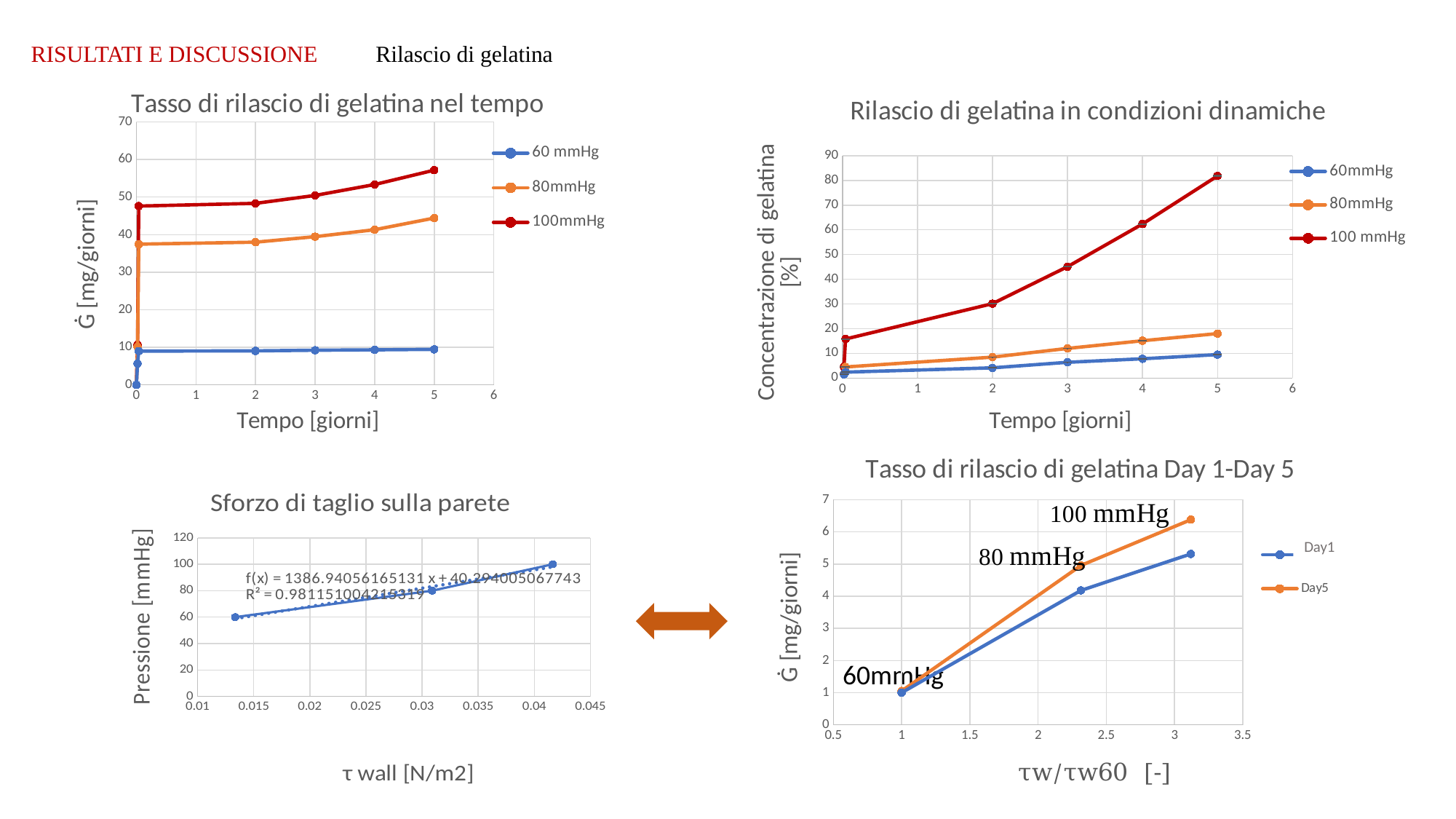
What kind of chart is "Tasso di rilascio di gelatina nel tempo"? line chart In "Tasso di rilascio di gelatina nel tempo", is the value of the 100mmHg series at day 5 greater or less than 50? greater In "Rilascio di gelatina in condizioni dinamiche", which series has the lowest value at day 5? 60mmHg In "Rilascio di gelatina in condizioni dinamiche", does the 100 mmHg series rise or fall over time? rise In "Tasso di rilascio di gelatina nel tempo", is the value of the 60 mmHg series at day 5 greater or less than 20? less In "Tasso di rilascio di gelatina Day 1-Day 5", which series is higher at the 100 mmHg point, Day1 or Day5? Day5 In "Tasso di rilascio di gelatina nel tempo", which series has the highest value at day 5? 100mmHg How many series does the legend of "Tasso di rilascio di gelatina Day 1-Day 5" list? 2 In "Rilascio di gelatina in condizioni dinamiche", is the value of the 100 mmHg series at day 5 greater or less than 70? greater How many data points are plotted in "Sforzo di taglio sulla parete"? 3 How many series does the legend of "Tasso di rilascio di gelatina nel tempo" list? 3 What is the x-axis label of "Sforzo di taglio sulla parete"? τ wall [N/m2]